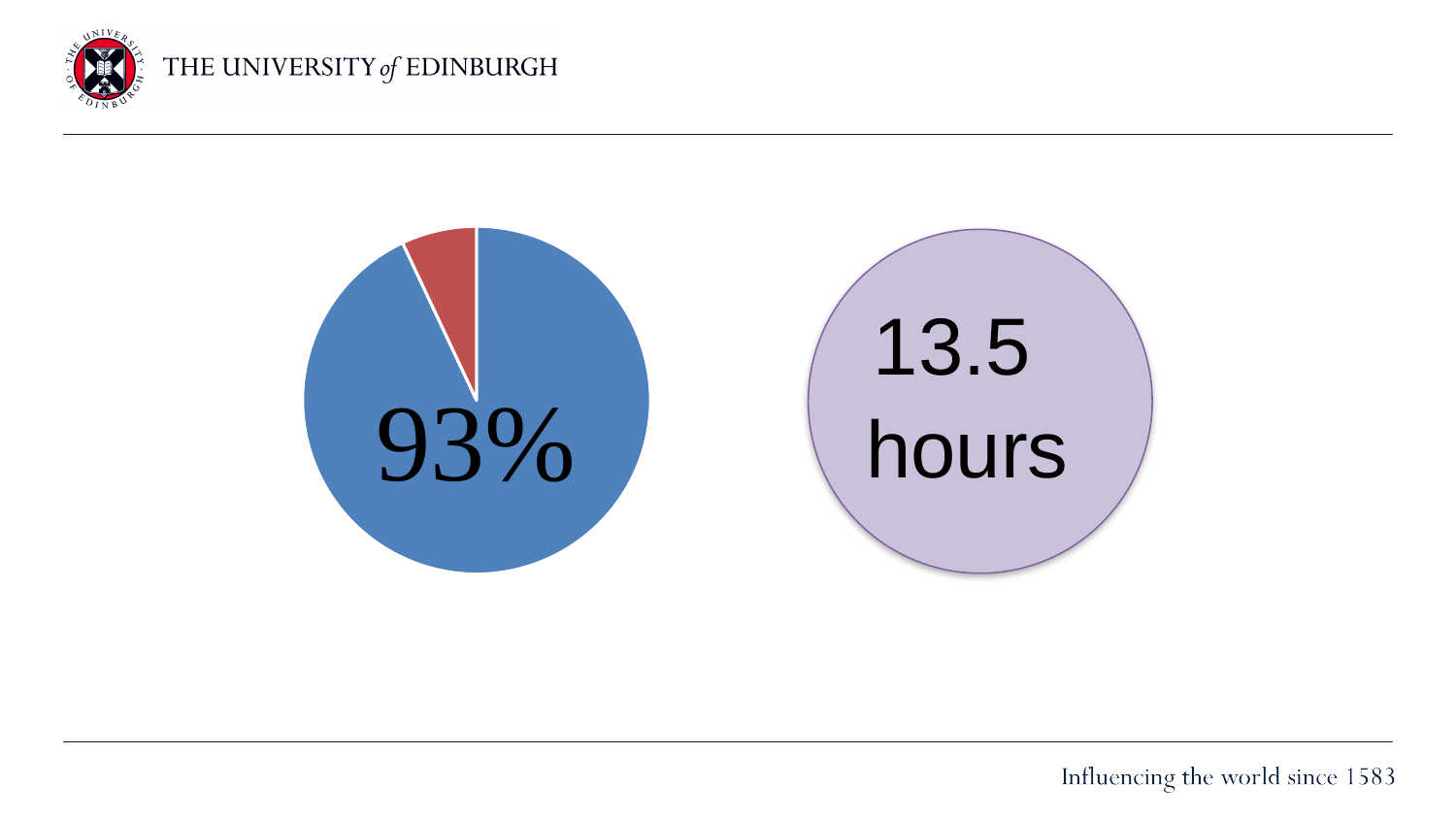
What value is printed on the large blue slice of the pie chart? 93% What kind of chart is shown on the left of the slide? pie chart Which slice of the pie chart is larger, the blue one or the red one? blue Is the share of the blue slice in the pie chart greater or less than 50%? greater Is the share of the red slice in the pie chart greater or less than 50%? less What text is printed inside the purple circle to the right of the pie chart? 13.5 hours What colour is the largest slice of the pie chart? blue How many slices does the pie chart have? 2